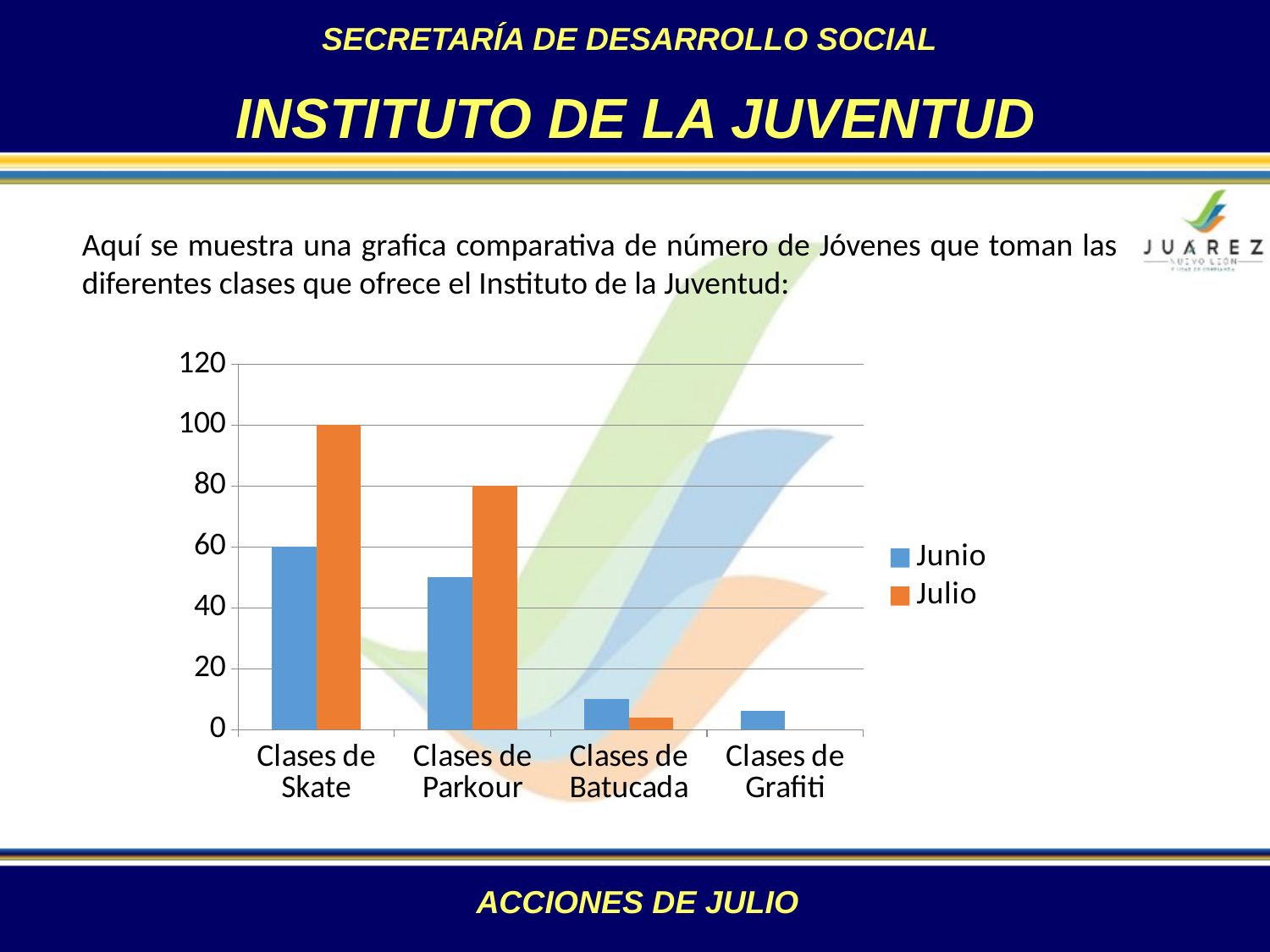
Which category has the highest Julio value? Clases de Skate Which category has the lowest Junio value? Clases de Grafiti How many series does the legend list? 2 How many class categories are shown on the x axis? 4 What is the Julio value for Clases de Parkour? 80 Is the Junio value for Clases de Parkour greater or less than 40? greater For Clases de Batucada, which is larger, the Junio value or the Julio value? Junio What is the Junio value for Clases de Skate? 60 What is the Julio value for Clases de Skate? 100 What is the difference between the Julio and Junio values for Clases de Skate? 40 What type of chart is shown on the slide? Bar chart Do the Junio values rise or fall from left to right across the categories? Fall